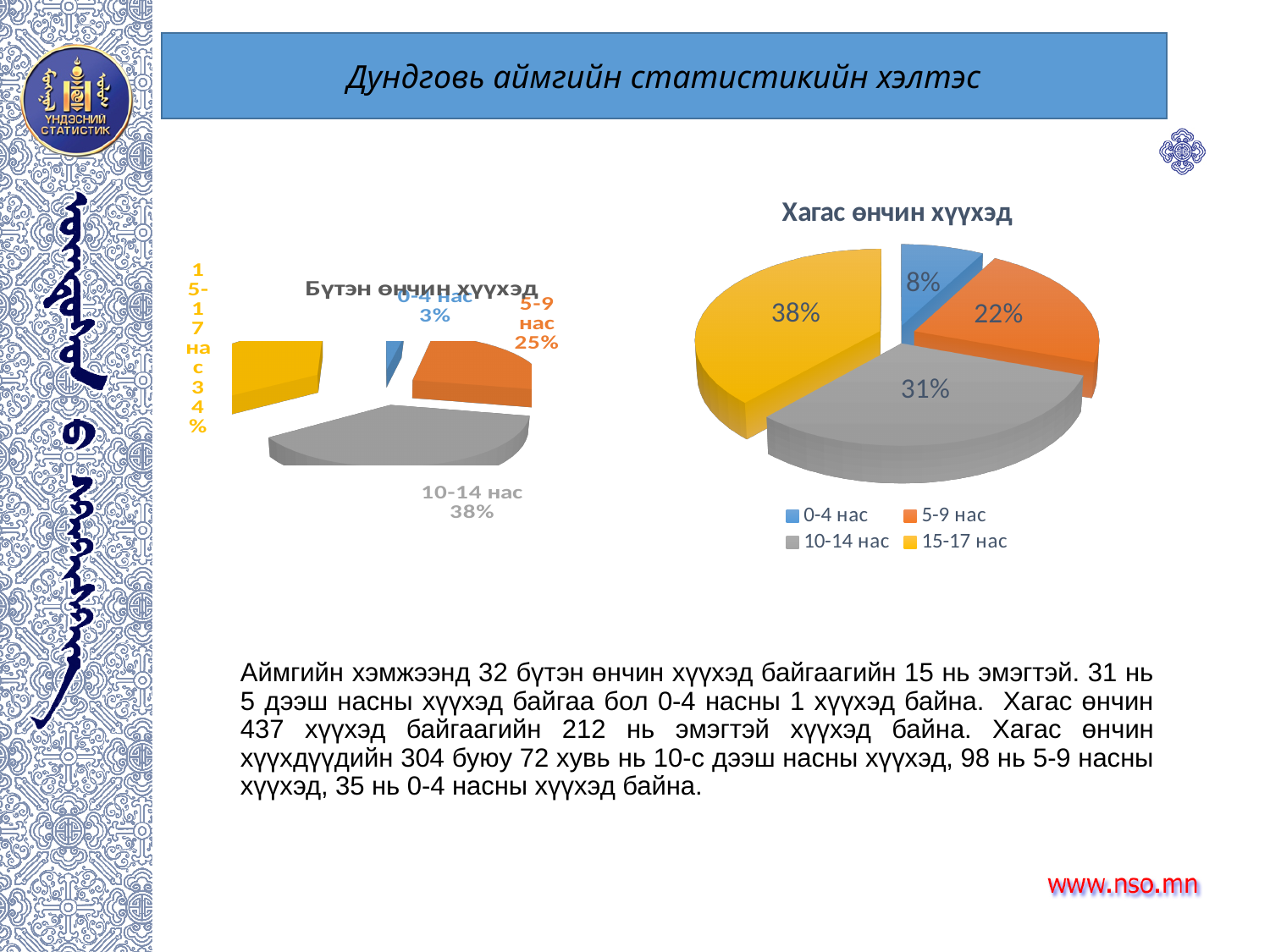
In the chart titled "Хагас өнчин хүүхэд", what share does the 5-9 нас slice have? 22% What type of chart is the chart titled "Хагас өнчин хүүхэд"? Pie chart In the chart titled "Хагас өнчин хүүхэд", what share does the 10-14 нас slice have? 31% In the chart titled "Хагас өнчин хүүхэд", what colour represents the 10-14 нас category? Gray In the chart titled "Бүтэн өнчин хүүхэд", which is larger, the 5-9 нас slice or the 10-14 нас slice? 10-14 нас In the chart titled "Хагас өнчин хүүхэд", what is the difference in percentage points between the 15-17 нас slice and the 0-4 нас slice? 30 In the chart titled "Хагас өнчин хүүхэд", which age group has the smallest slice? 0-4 нас In the chart titled "Бүтэн өнчин хүүхэд", what share does the 10-14 нас slice have? 38% In the chart titled "Бүтэн өнчин хүүхэд", which age group has the smallest slice? 0-4 нас In the chart titled "Хагас өнчин хүүхэд", how many categories does the legend list? 4 In the chart titled "Хагас өнчин хүүхэд", which age group has the largest slice? 15-17 нас